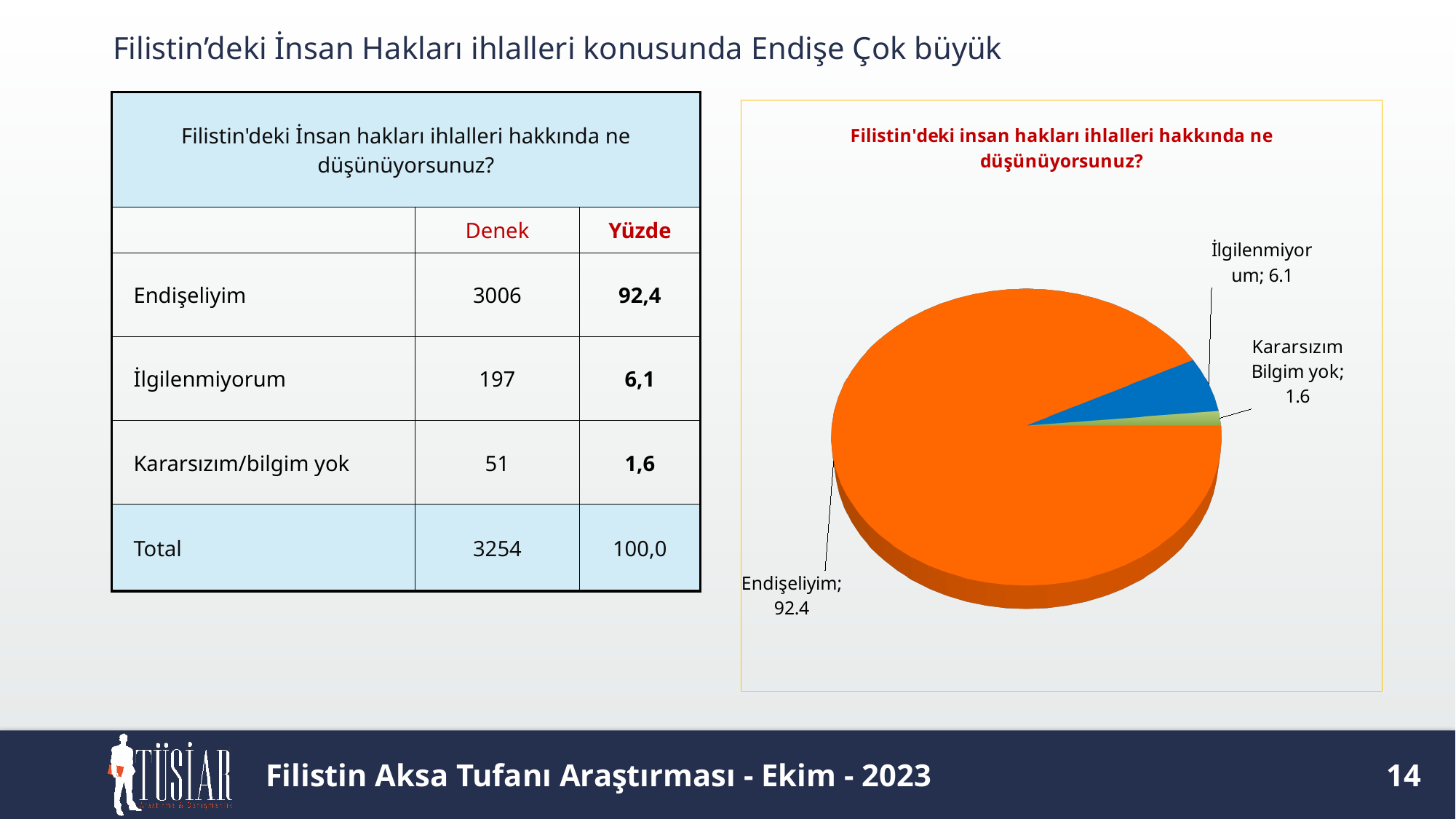
What is the value shown for the Kararsızım Bilgim yok slice in the pie chart? 1.6 What type of chart is shown on the slide? pie chart What is the value shown for the Endişeliyim slice in the pie chart? 92.4 What is the value shown for the İlgilenmiyorum slice in the pie chart? 6.1 What is the difference between the Endişeliyim and İlgilenmiyorum values in the pie chart? 86.3 Which slice of the pie chart is the smallest? Kararsızım Bilgim yok What is the difference between the İlgilenmiyorum and Kararsızım Bilgim yok values in the pie chart? 4.5 Which slice of the pie chart is the largest? Endişeliyim Which is larger in the pie chart, İlgilenmiyorum or Kararsızım Bilgim yok? İlgilenmiyorum What is the title of the pie chart? Filistin'deki insan hakları ihlalleri hakkında ne düşünüyorsunuz? How many slices does the pie chart have? 3 What colour is the Endişeliyim slice in the pie chart? orange